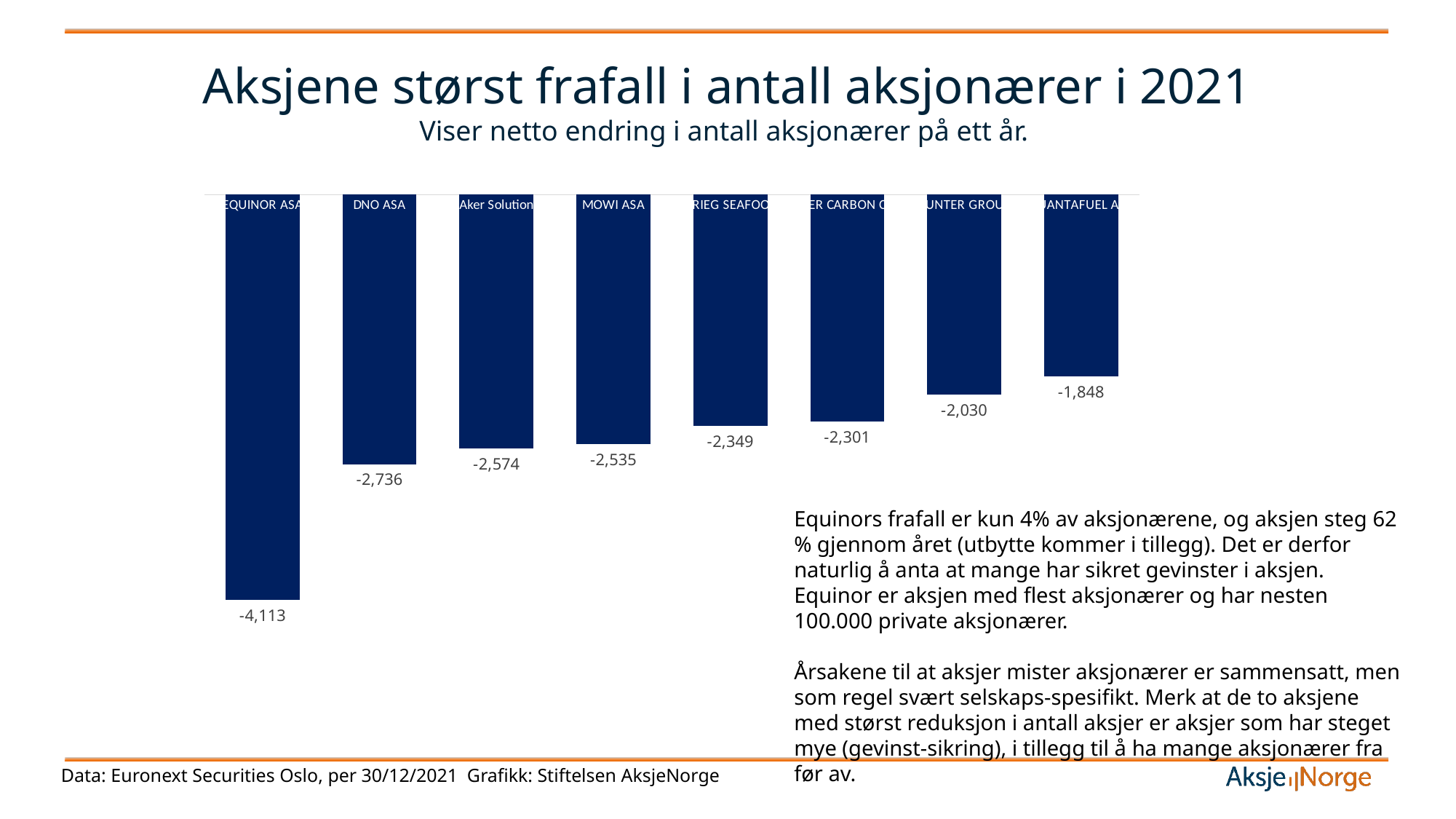
Which has the larger decline in shareholders, DNO ASA or MOWI ASA? DNO ASA What is the difference between the values for Aker Solutions and MOWI ASA? 39 What is the value shown for MOWI ASA? -2,535 Which company has the lowest (most negative) value in the chart? EQUINOR ASA Do the bar values rise or fall from left to right across the chart? Rise What is the value shown for DNO ASA? -2,736 What is the value shown for Aker Solutions? -2,574 What is the value shown for EQUINOR ASA? -4,113 What is the title of the slide? Aksjene størst frafall i antall aksjonærer i 2021 What is the difference between the values for EQUINOR ASA and DNO ASA? 1,377 What kind of chart is shown on the slide? Bar chart How many bars are plotted in the chart? 8